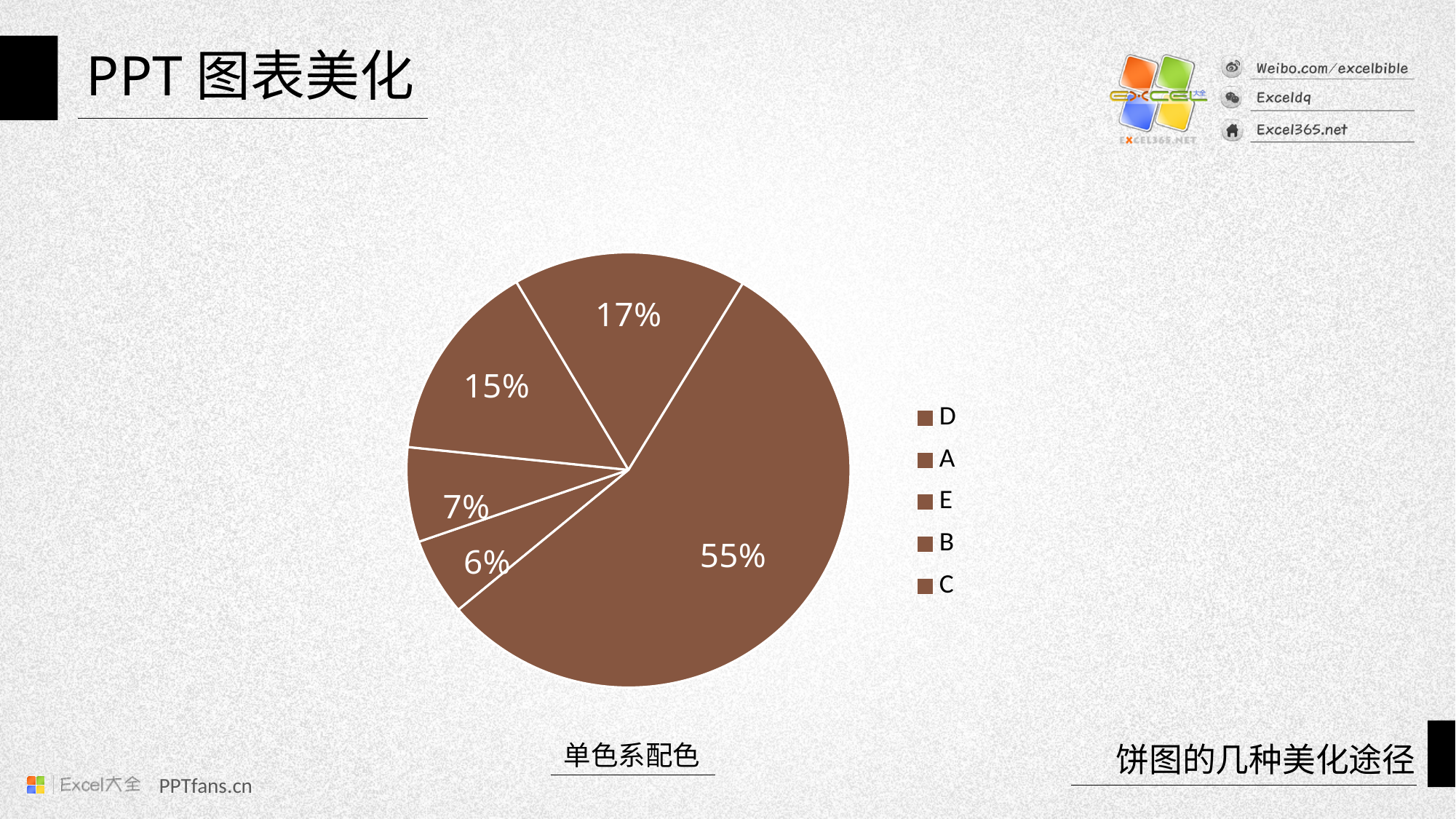
Which is larger on the pie chart, the 17% slice or the 15% slice? 17% What is the largest percentage shown on the pie chart? 55% What kind of chart is shown on the slide? pie chart What is the smallest percentage shown on the pie chart? 6% How many entries does the legend of the pie chart list? 5 Is the largest slice of the pie chart greater or less than 50%? greater What share of the pie does the largest slice take? 55% What is the difference between the 17% slice and the 15% slice of the pie chart? 2% What is the difference between the largest slice (55%) and the smallest slice (6%) of the pie chart? 49% What caption appears directly below the pie chart? 单色系配色 How many slices does the pie chart have? 5 What are the legend entries of the pie chart, in order from top to bottom? D, A, E, B, C